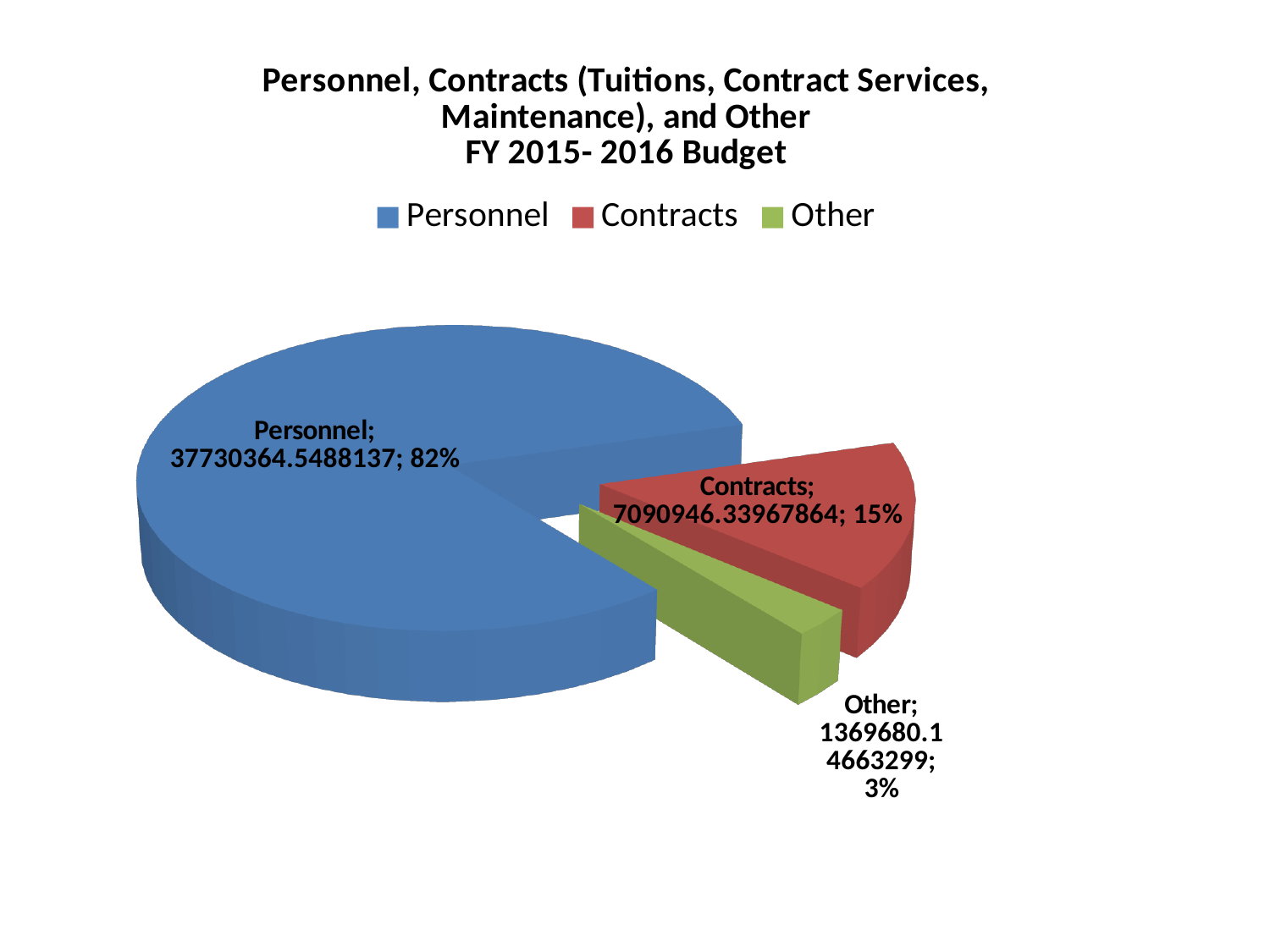
Which is larger, Contracts or Other? Contracts What share of the pie does Other represent? 3% What colour is the Contracts slice? Red What is the value for Other? 1369680.14663299 Which category has the smallest slice? Other What is the value for Contracts? 7090946.33967864 What is the value for Personnel? 37730364.5488137 What share of the pie does Personnel represent? 82% Which category has the largest slice? Personnel What share of the pie does Contracts represent? 15% What kind of chart is shown on the slide? Pie chart How many slices does the pie chart have? 3